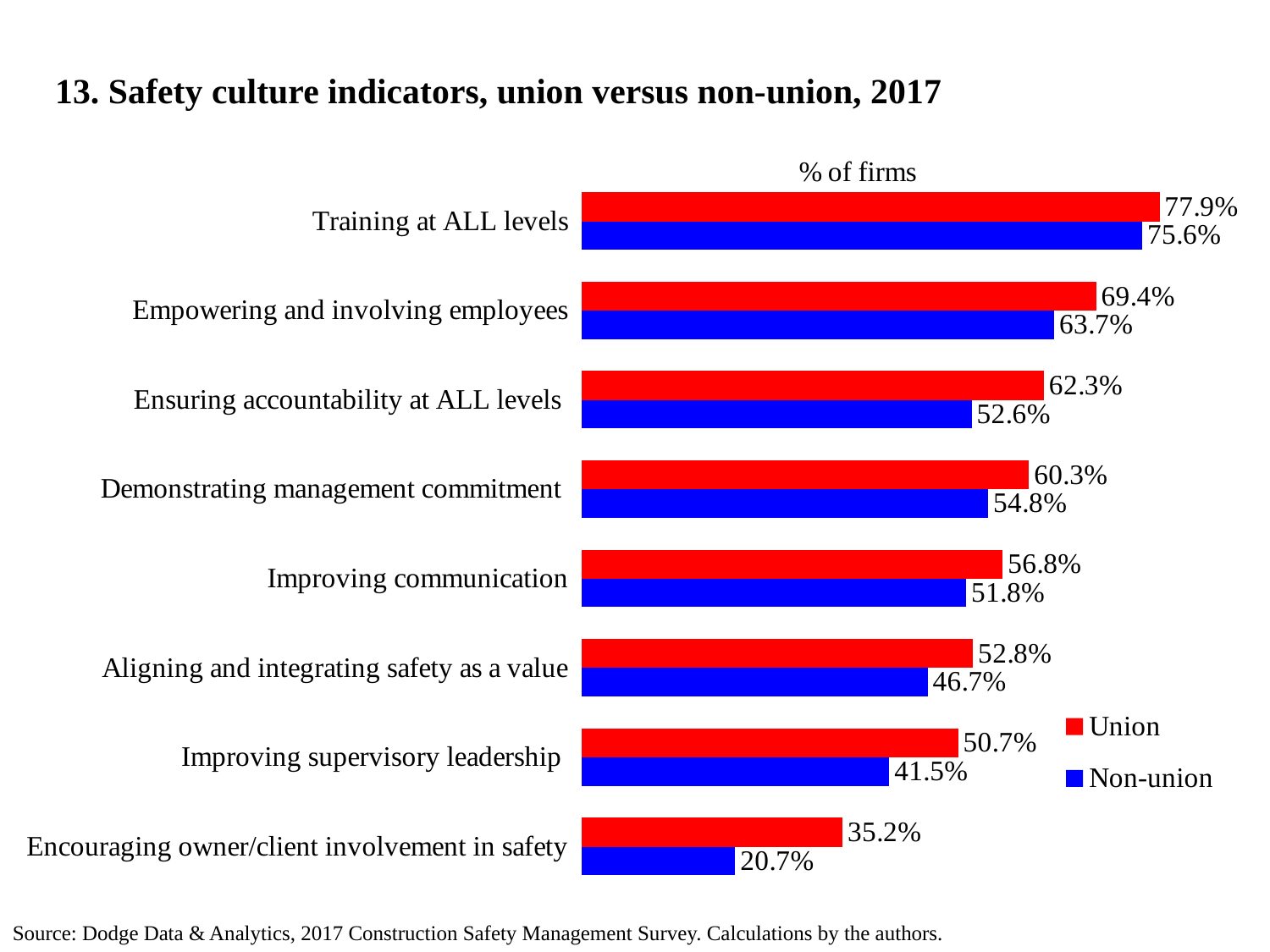
What is the non-union value for encouraging owner/client involvement in safety? 20.7% What is the difference between the union and non-union values for encouraging owner/client involvement in safety? 14.5 percentage points How many series does the legend list? 2 What is the union value for improving supervisory leadership? 50.7% Which colour represents non-union firms in the chart? Blue What percentage of union firms reported training at ALL levels? 77.9% What type of chart is shown on the slide? Bar chart What is the difference between the union and non-union values for ensuring accountability at ALL levels? 9.7 percentage points Which safety culture indicator has the highest non-union value? Training at ALL levels Which safety culture indicator has the lowest union value? Encouraging owner/client involvement in safety For aligning and integrating safety as a value, which group has the higher value, union or non-union? Union How many safety culture indicators are shown in the chart? 8